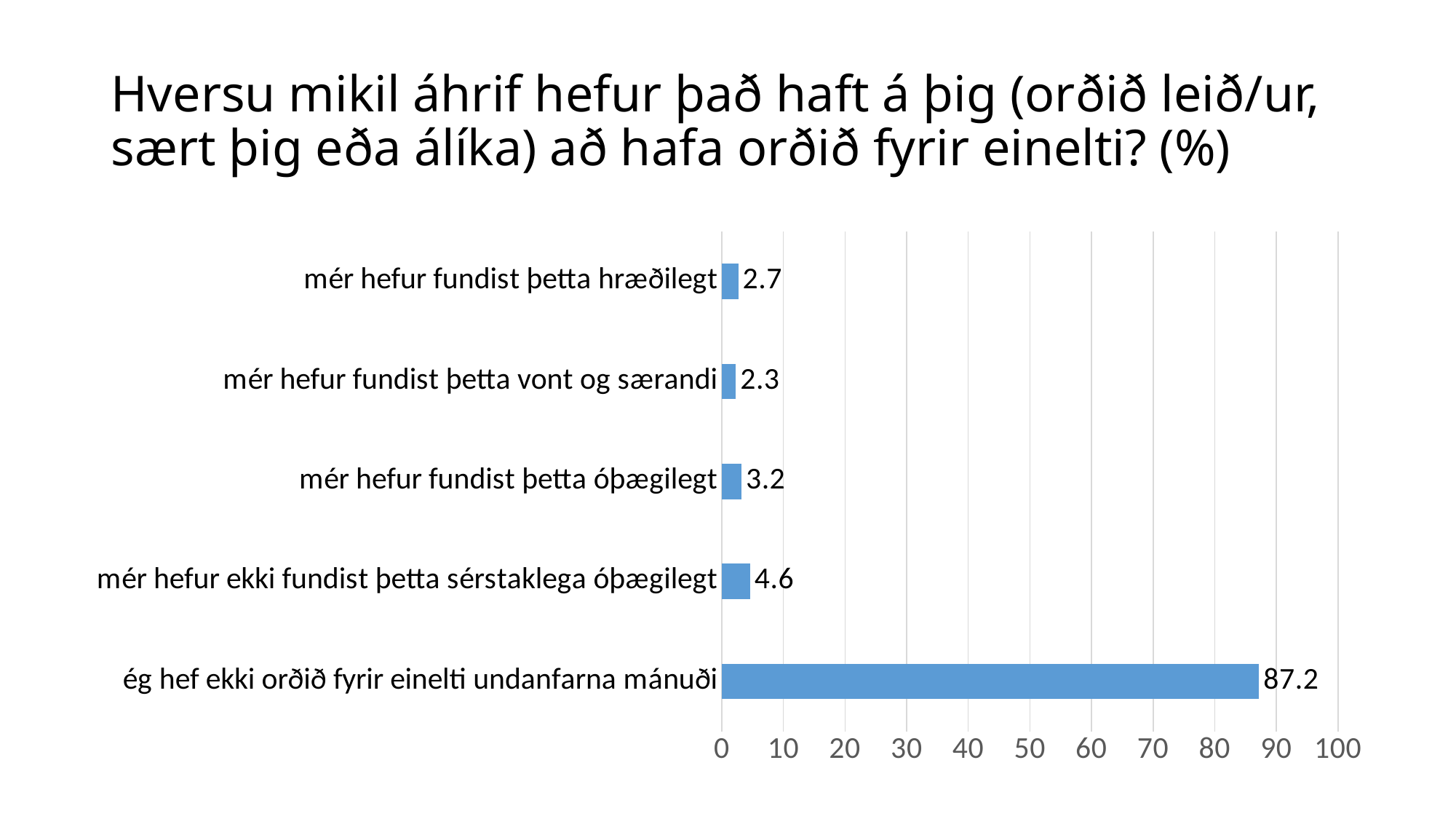
Which category has the highest value? ég hef ekki orðið fyrir einelti undanfarna mánuði Which category has the lowest value? mér hefur fundist þetta vont og særandi What kind of chart is shown on the slide? bar chart What is the maximum value shown on the horizontal axis? 100 What is the difference between the values for "mér hefur ekki fundist þetta sérstaklega óþægilegt" and "mér hefur fundist þetta óþægilegt"? 1.4 What is the value for "mér hefur fundist þetta óþægilegt"? 3.2 What is the value for "ég hef ekki orðið fyrir einelti undanfarna mánuði"? 87.2 Is the value for "ég hef ekki orðið fyrir einelti undanfarna mánuði" greater or less than 80? greater Which is larger: the value for "mér hefur fundist þetta hræðilegt" or "mér hefur fundist þetta vont og særandi"? mér hefur fundist þetta hræðilegt What is the value for "mér hefur fundist þetta hræðilegt"? 2.7 How many categories are shown in the chart? 5 What is the value for "mér hefur fundist þetta vont og særandi"? 2.3